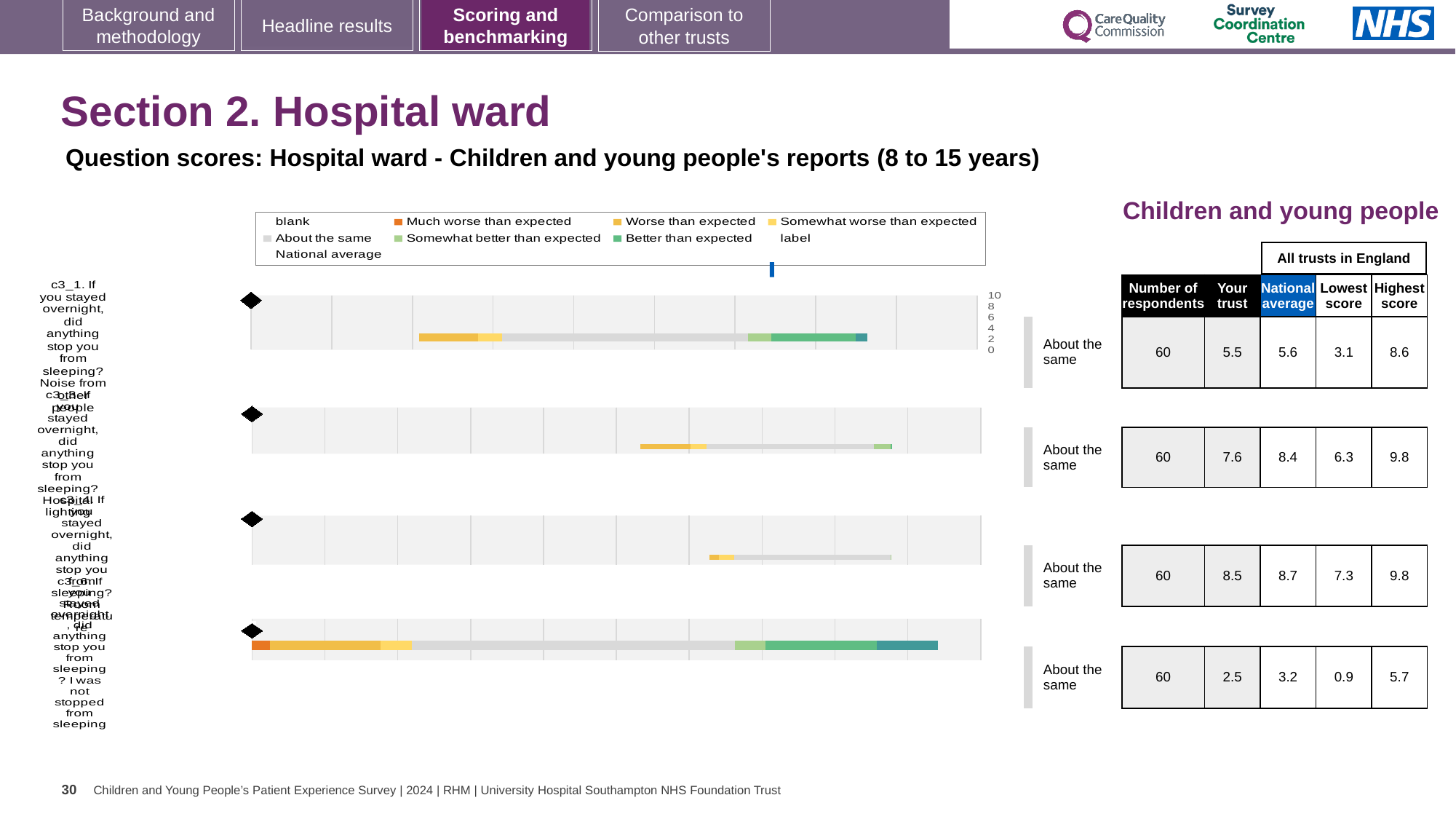
In the chart legend, which colour represents 'About the same'? grey In the table on the right, what is the 'Highest score' for the fourth (bottom) row? 5.7 In the table on the right, how many respondents are listed for each row? 60 In the table on the right, what is the 'National average' for the second row? 8.4 In the table on the right, is the 'Your trust' score in the second row larger or smaller than the 'National average' in that row? smaller In the table on the right, what is the difference between the 'National average' and 'Your trust' score in the fourth (bottom) row? 0.7 How many separate benchmark bar charts are shown on the slide? 4 In the table on the right, which row has the highest 'Your trust' score? the third row (8.5) In the chart legend, which colour represents 'Much worse than expected'? orange In the table on the right, what is the 'Lowest score' for the third row? 7.3 In the table on the right, what is the 'Your trust' score for the first (top) row? 5.5 What kind of chart is used for the four benchmark charts on the left of the slide? bar chart